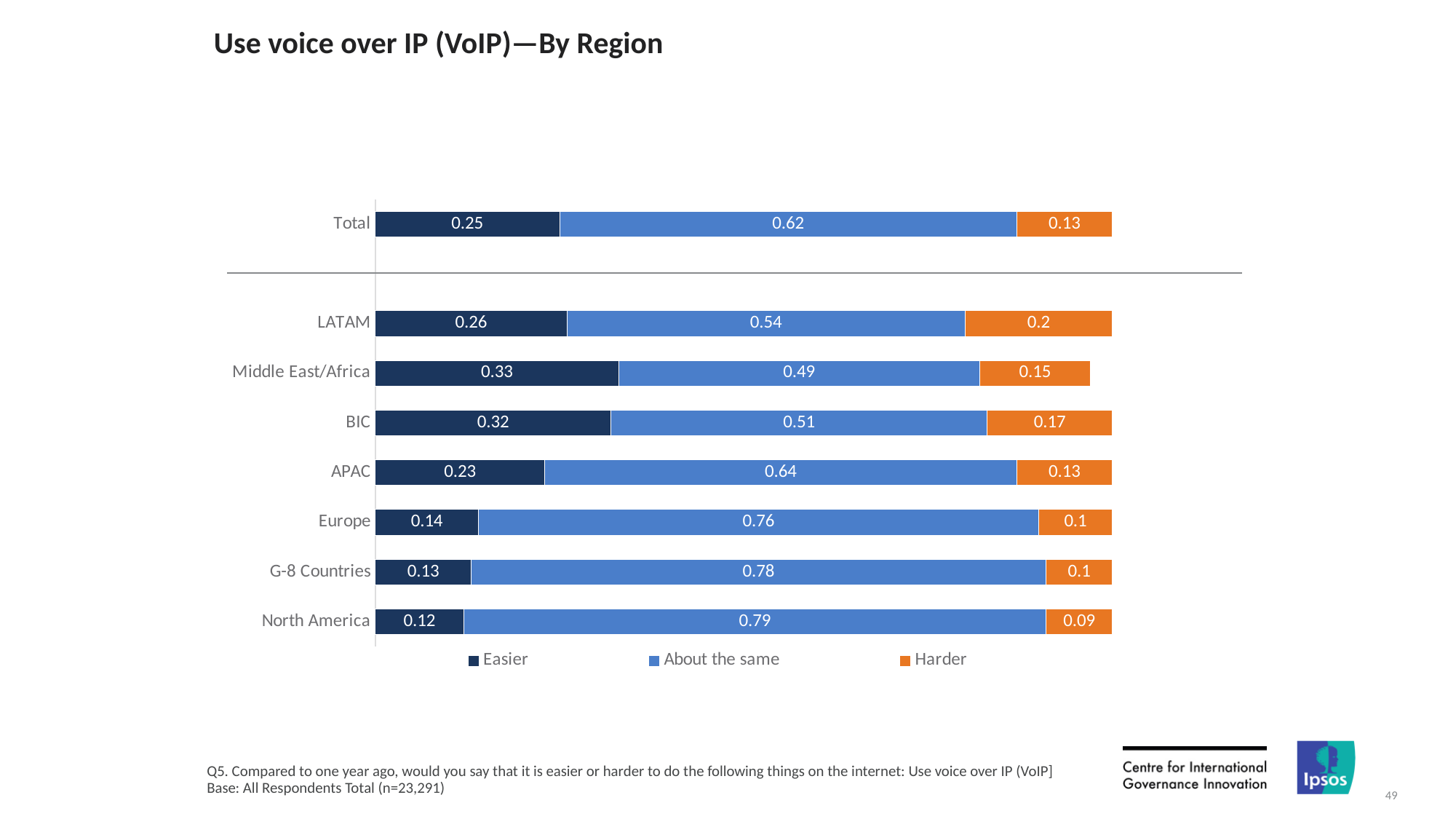
What kind of chart is shown on the slide? Stacked bar chart Which colour represents the 'Harder' series in the legend? Orange Is the 'Easier' value larger for BIC or for APAC? BIC What is the 'Harder' value for LATAM? 0.2 What is the total of the stacked bar for Europe? 1 Which region has the lowest 'Easier' value? North America Which region has the highest 'About the same' value? North America How many regions are shown below the Total bar? 7 What is the difference between the 'About the same' values for G-8 Countries and LATAM? 0.24 How many series does the legend list? 3 What is the 'About the same' value for North America? 0.79 What is the 'Easier' value for Middle East/Africa? 0.33